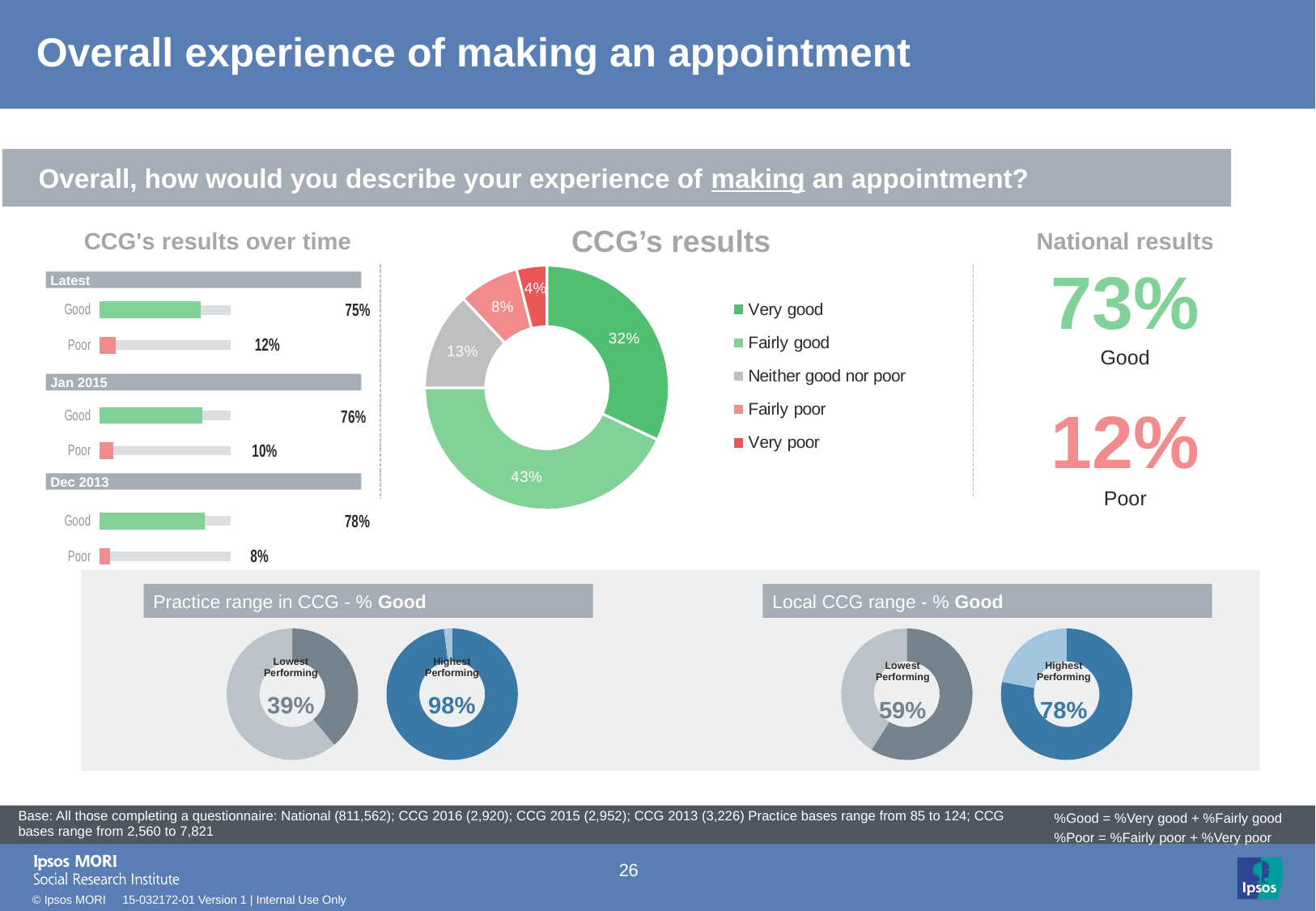
In the "Local CCG range - % Good" section, what is the Lowest Performing value? 59% In the "CCG's results" donut chart, which category has the smallest share? Very poor In the "CCG's results over time" chart, does the Good value rise or fall from Dec 2013 to Latest? fall In the "CCG's results" donut chart, which category has the largest share? Fairly good How many categories does the legend of the "CCG's results" donut chart list? 5 In the "CCG's results" donut chart, what percentage is shown for Fairly good? 43% In the "CCG's results" donut chart, what percentage is shown for Neither good nor poor? 13% In the "CCG's results over time" chart, what is the Good value for Latest? 75% In the "CCG's results over time" chart, what is the difference between the Good value for Dec 2013 and the Good value for Latest? 3% In the "Practice range in CCG - % Good" section, what is the Highest Performing value? 98% In the "CCG's results over time" chart, what is the Poor value for Dec 2013? 8% In the "CCG's results" donut chart, what percentage is shown for Very good? 32%